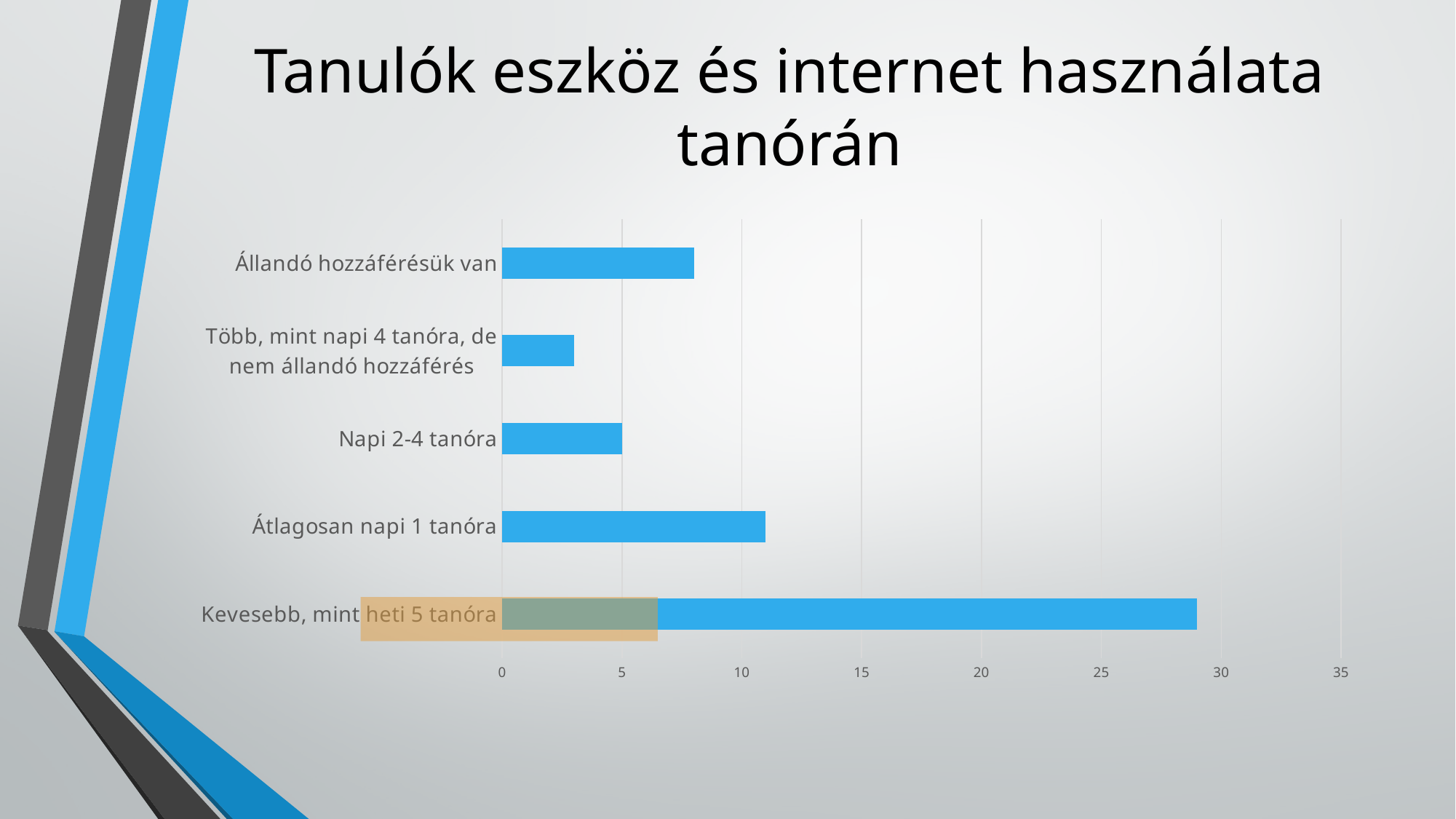
Which category has the highest value? Kevesebb, mint heti 5 tanóra What kind of chart is shown on the slide? bar chart Is the value for Állandó hozzáférésük van greater or less than 5? greater Which is larger: the value for Átlagosan napi 1 tanóra or the value for Állandó hozzáférésük van? Átlagosan napi 1 tanóra Is the value for Állandó hozzáférésük van greater or less than 10? less What is the title of the slide? Tanulók eszköz és internet használata tanórán Is the value for Több, mint napi 4 tanóra, de nem állandó hozzáférés greater or less than 5? less Which category has the lowest value? Több, mint napi 4 tanóra, de nem állandó hozzáférés How many categories are plotted in the chart? 5 What is the highest value shown on the horizontal axis? 35